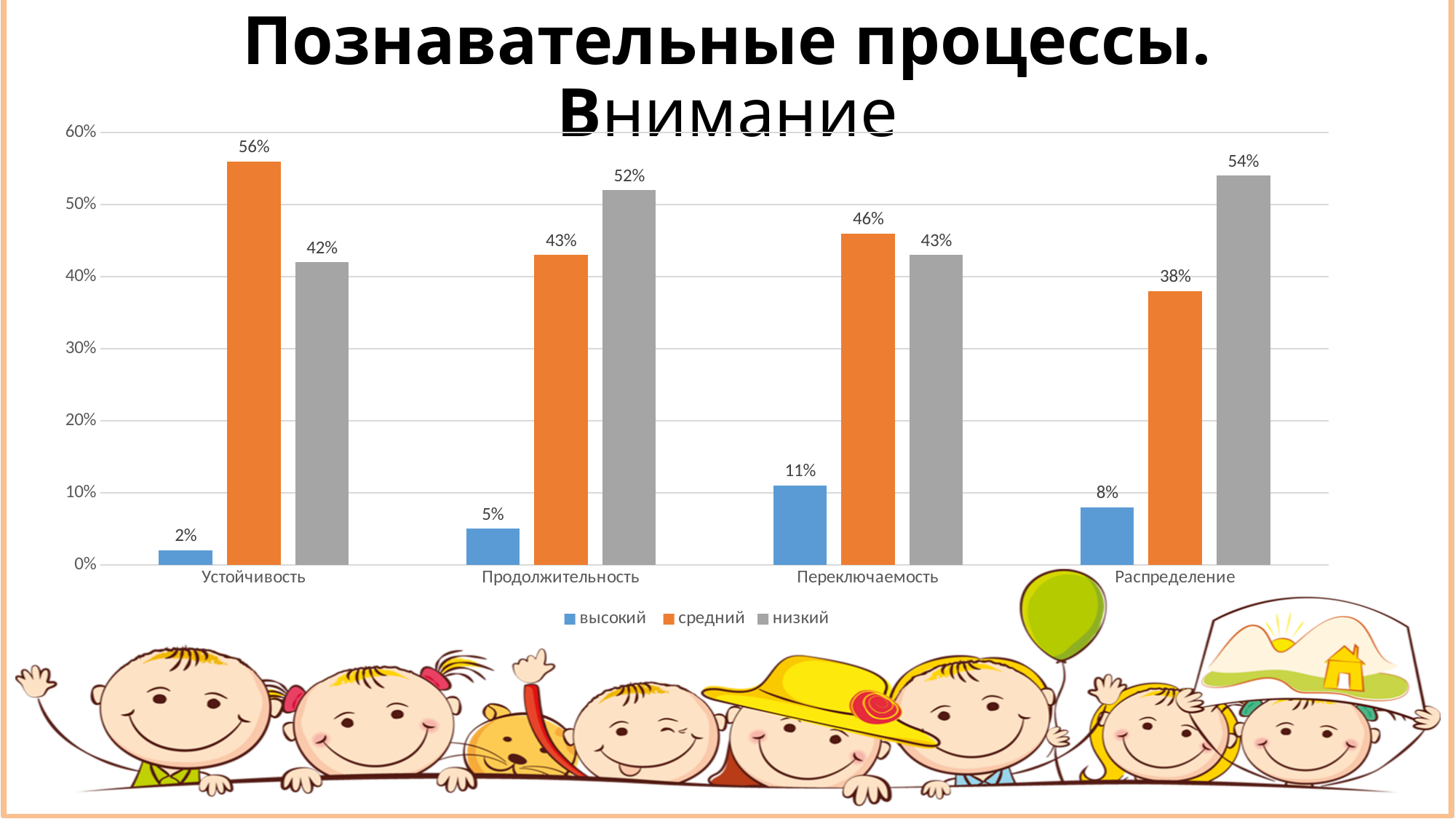
What is the value of the средний series for Устойчивость? 56% Is the value of the низкий series for Устойчивость greater or less than 40%? greater What is the difference between the низкий and средний values for Продолжительность? 9% What colour are the bars for the средний series? orange Which category has the highest value for the высокий series? Переключаемость What is the value of the высокий series for Переключаемость? 11% What is the value of the низкий series for Распределение? 54% Which category has the lowest value for the средний series? Распределение How many series does the legend list? 3 What kind of chart is shown on the slide? bar chart How many categories are shown on the x axis? 4 For Переключаемость, which is larger: the средний value or the низкий value? средний